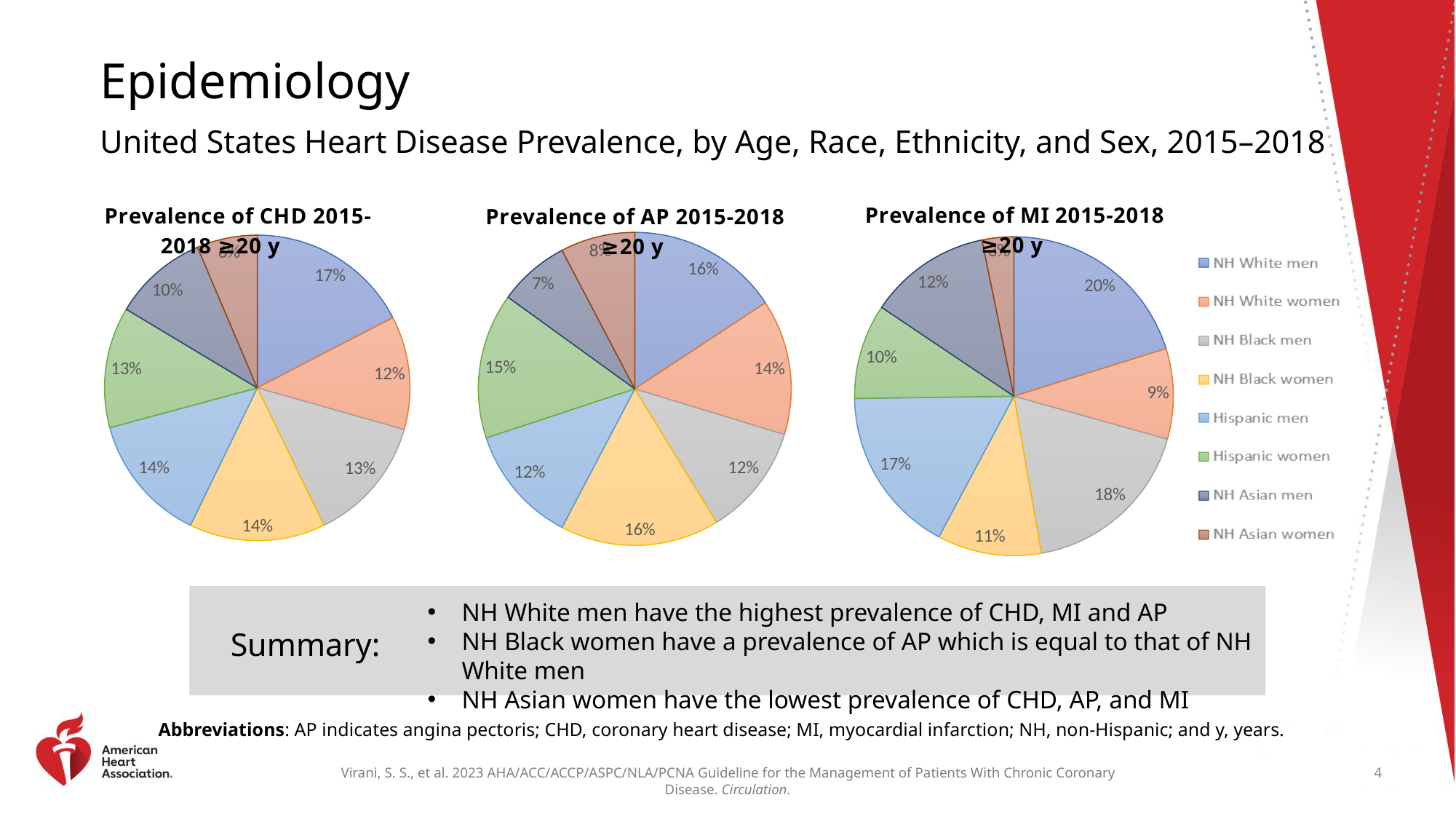
In the Prevalence of MI 2015-2018 chart, what is the difference between the shares for NH White men and NH White women? 11 percentage points In the Prevalence of MI 2015-2018 chart, which group has the largest slice? NH White men In the Prevalence of AP 2015-2018 chart, what share is shown for Hispanic women? 15% What type of chart is used to show the Prevalence of CHD 2015-2018? Pie chart How many slices does the Prevalence of AP 2015-2018 pie chart have? 8 In the Prevalence of CHD 2015-2018 chart, what share is shown for NH White men? 17% In the Prevalence of CHD 2015-2018 chart, which is larger: the share for NH White women or the share for Hispanic men? Hispanic men In the Prevalence of MI 2015-2018 chart, what share is shown for Hispanic men? 17% In the Prevalence of AP 2015-2018 chart, what share is shown for NH Black women? 16% In the Prevalence of AP 2015-2018 chart, which group has the smallest slice? NH Asian men In the Prevalence of MI 2015-2018 chart, what share is shown for NH Black men? 18% How many groups does the legend list for the pie charts? 8